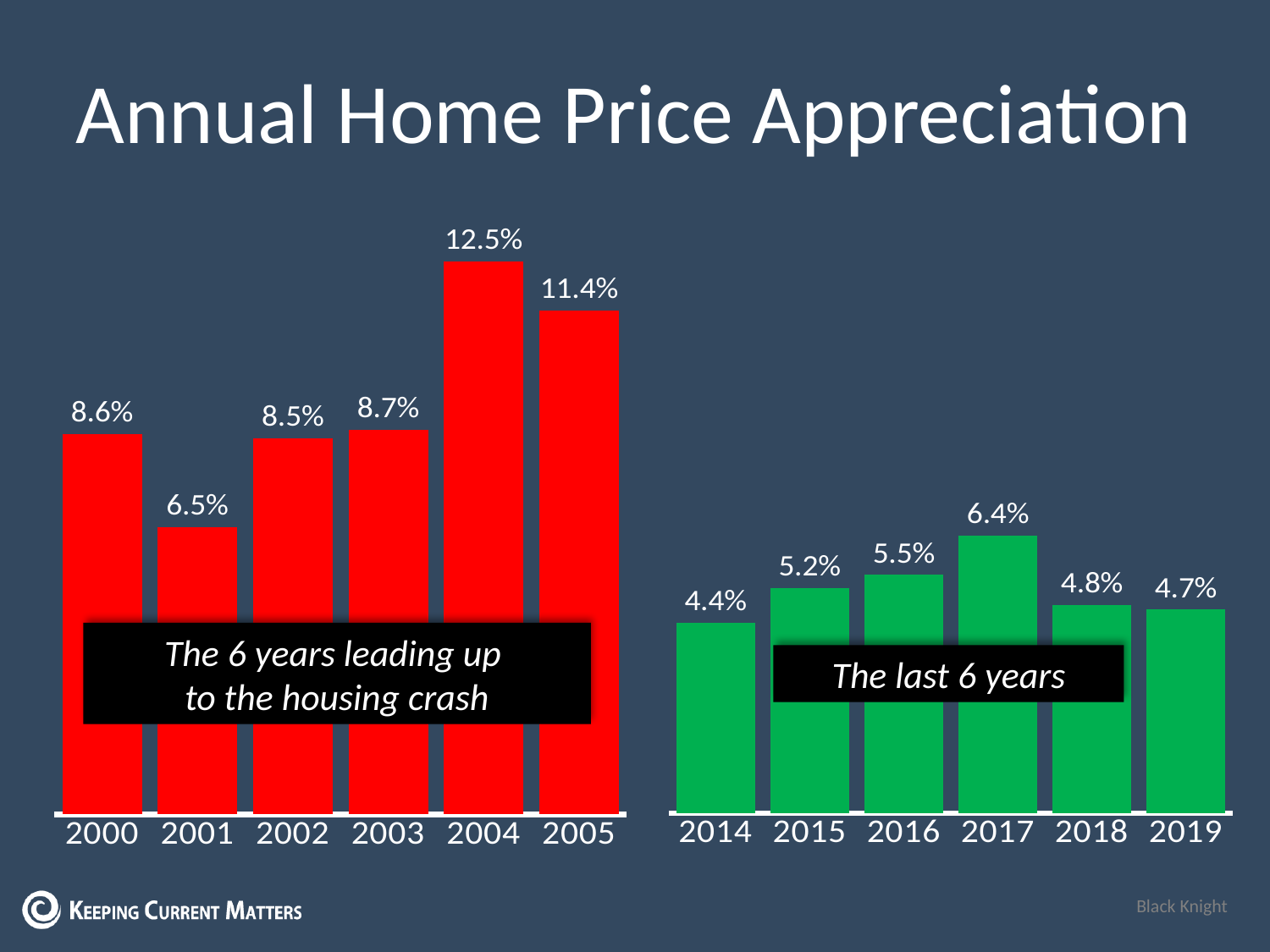
In the right chart (the last 6 years), which year has the lowest appreciation? 2014 In the left chart (the 6 years leading up to the housing crash), what is the annual home price appreciation for 2004? 12.5% In the left chart (the 6 years leading up to the housing crash), which is larger, the value for 2001 or the value for 2003? 2003 What colour are the bars in the right chart (the last 6 years)? Green In the left chart (the 6 years leading up to the housing crash), what is the difference between the 2004 and 2005 values? 1.1% In the right chart (the last 6 years), which is larger, the value for 2015 or the value for 2016? 2016 In the right chart (the last 6 years), which year has the highest appreciation? 2017 In the right chart (the last 6 years), what is the annual home price appreciation for 2017? 6.4% How many years are shown in the right chart (the last 6 years)? 6 What kind of chart is the left chart (the 6 years leading up to the housing crash)? Bar chart In the left chart (the 6 years leading up to the housing crash), which year has the lowest appreciation? 2001 In the right chart (the last 6 years), what is the difference between the 2017 and 2014 values? 2.0%